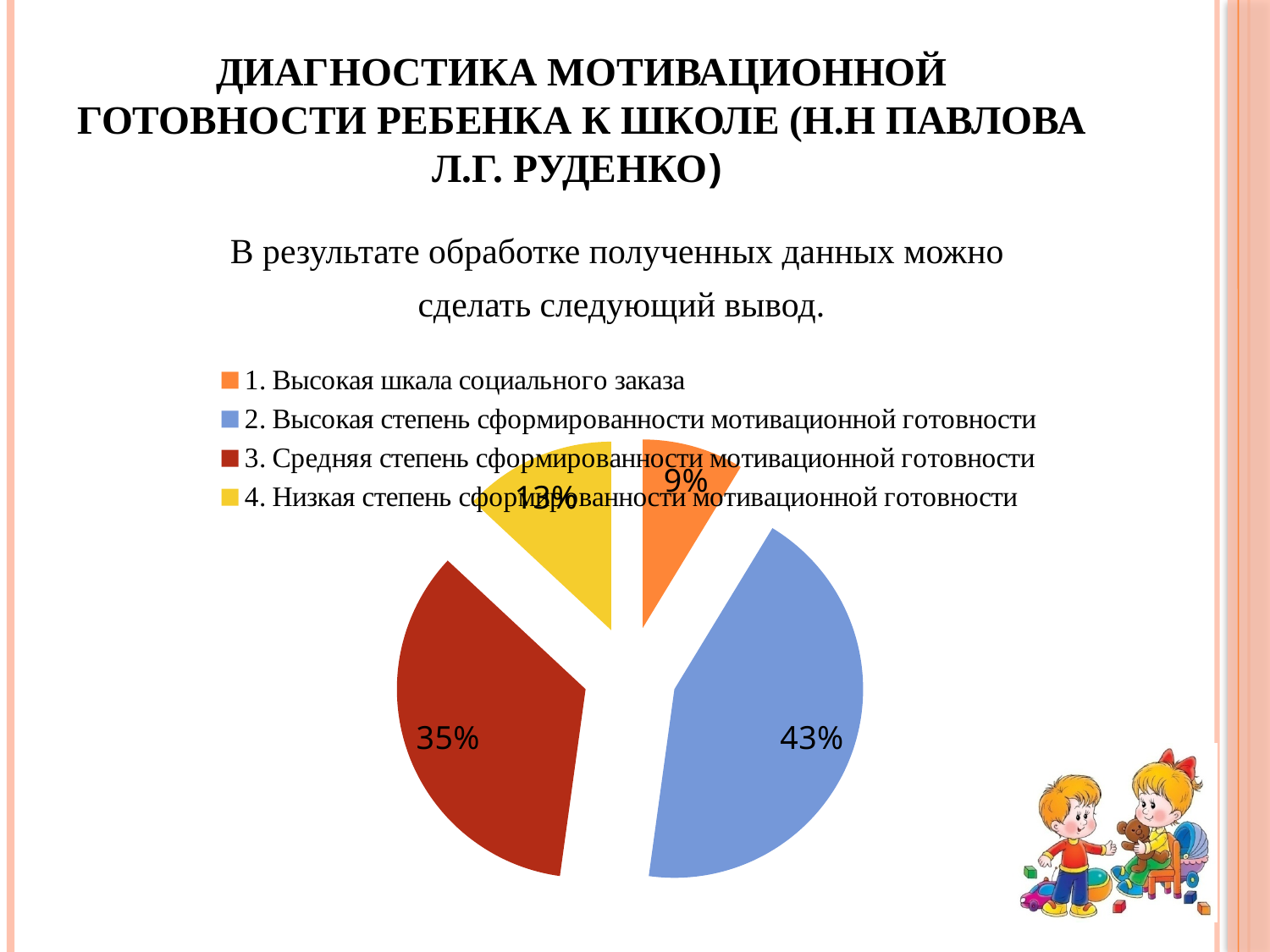
Which category has the largest share of the pie? 2. Высокая степень сформированности мотивационной готовности What percentage is shown for "4. Низкая степень сформированности мотивационной готовности"? 13% How many slices does the pie chart have? 4 What colour is the slice for "3. Средняя степень сформированности мотивационной готовности"? red How many entries does the legend of the pie chart list? 4 What percentage is shown for "2. Высокая степень сформированности мотивационной готовности"? 43% Which is larger: the share for "4. Низкая степень сформированности мотивационной готовности" or for "1. Высокая шкала социального заказа"? 4. Низкая степень сформированности мотивационной готовности What percentage is shown for "3. Средняя степень сформированности мотивационной готовности"? 35% What percentage is shown for "1. Высокая шкала социального заказа"? 9% What is the difference between the shares for "2. Высокая степень сформированности мотивационной готовности" and "3. Средняя степень сформированности мотивационной готовности"? 8% Which category has the smallest share of the pie? 1. Высокая шкала социального заказа What kind of chart is shown on the slide? pie chart